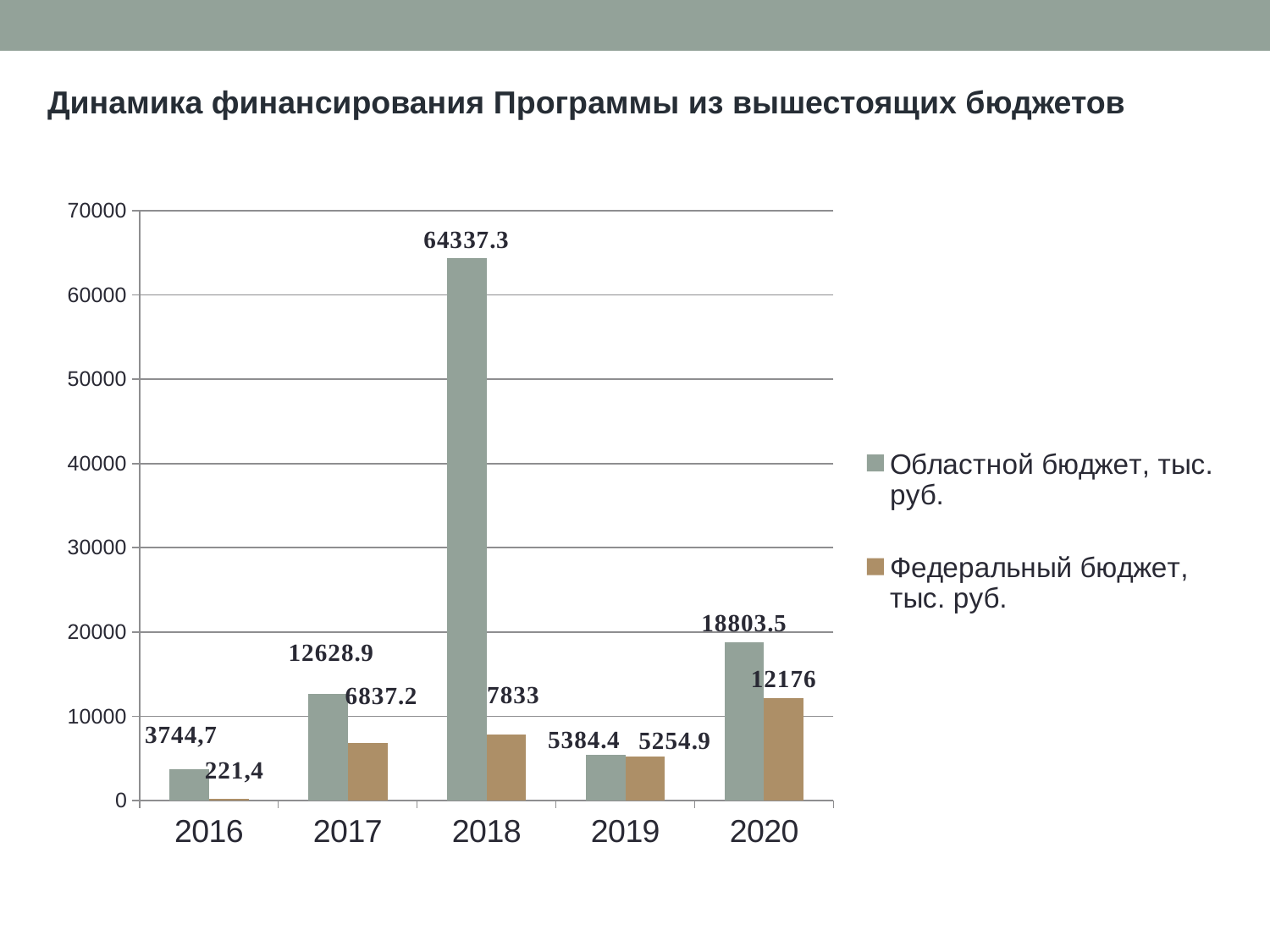
What is the value of the Областной бюджет series for 2018? 64337.3 What kind of chart is shown on the slide? bar chart Which is larger in 2017, the Областной бюджет value or the Федеральный бюджет value? Областной бюджет In which year is the Федеральный бюджет value lowest? 2016 Is the Областной бюджет value for 2018 greater or less than 60000? greater What is the difference between the Областной бюджет and Федеральный бюджет values in 2018? 56504.3 How many series does the legend list? 2 What is the value of the Федеральный бюджет series for 2020? 12176 In which year is the Областной бюджет value highest? 2018 How many years are shown on the x axis? 5 What is the value of the Федеральный бюджет series for 2016? 221,4 What is the difference between the Областной бюджет and Федеральный бюджет values in 2020? 6627.5